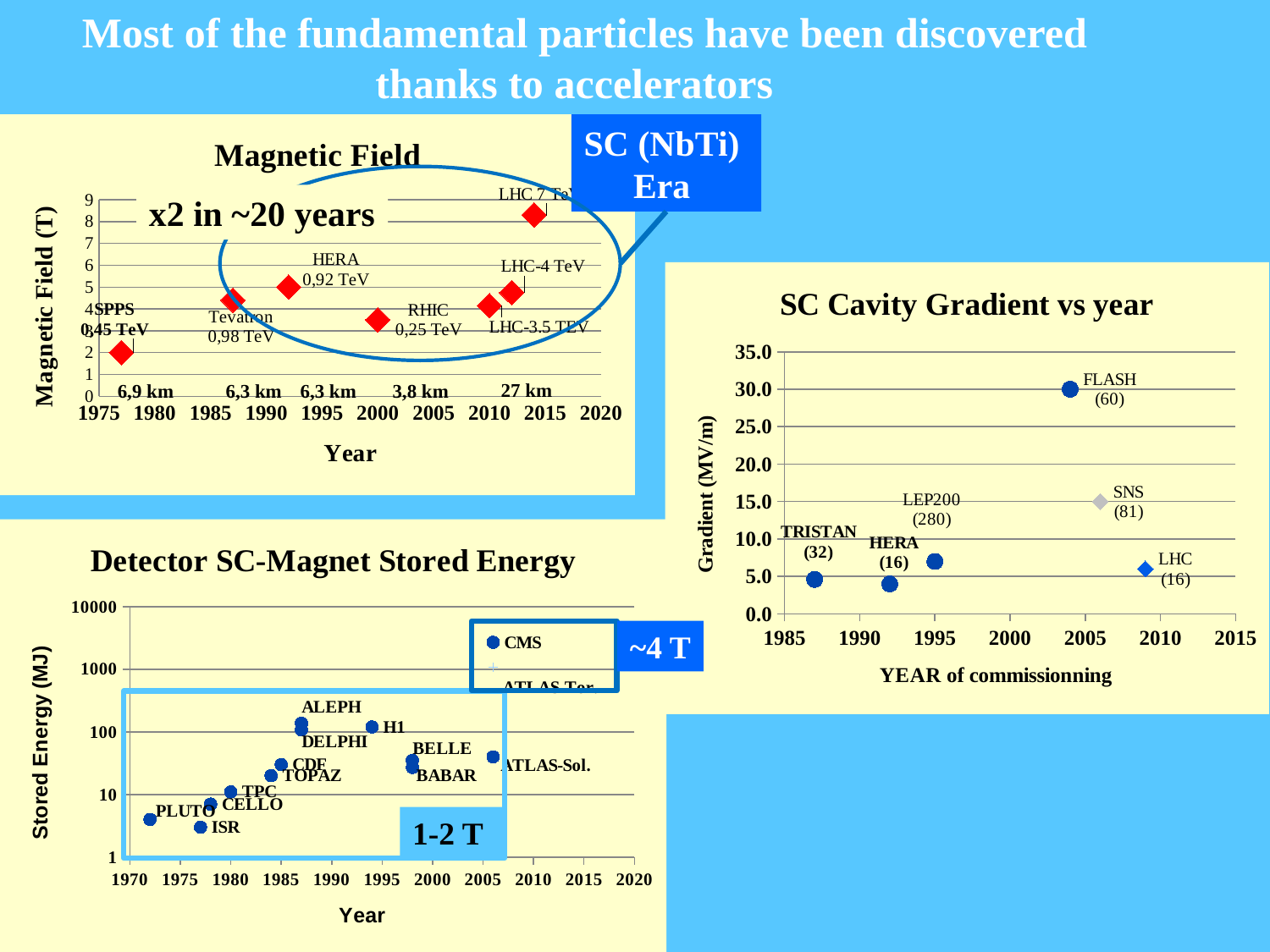
In the "Magnetic Field" chart, which accelerator has the lowest magnetic field? SPPS In the "Detector SC-Magnet Stored Energy" chart, which has the larger stored energy, ALEPH or PLUTO? ALEPH In the "Magnetic Field" chart, what is the y-axis title? Magnetic Field (T) In the "Magnetic Field" chart, is the value for SPPS greater or less than 3? less In the "SC Cavity Gradient vs year" chart, is the value for FLASH greater or less than 25.0? greater In the "SC Cavity Gradient vs year" chart, which has the larger gradient, FLASH or SNS? FLASH In the "SC Cavity Gradient vs year" chart, which facility has the highest gradient? FLASH In the "Magnetic Field" chart, is the value for LHC 7 TeV greater or less than 7? greater What kind of chart is the "Magnetic Field" chart? scatter chart In the "Magnetic Field" chart, which accelerator has the highest magnetic field? LHC 7 TeV